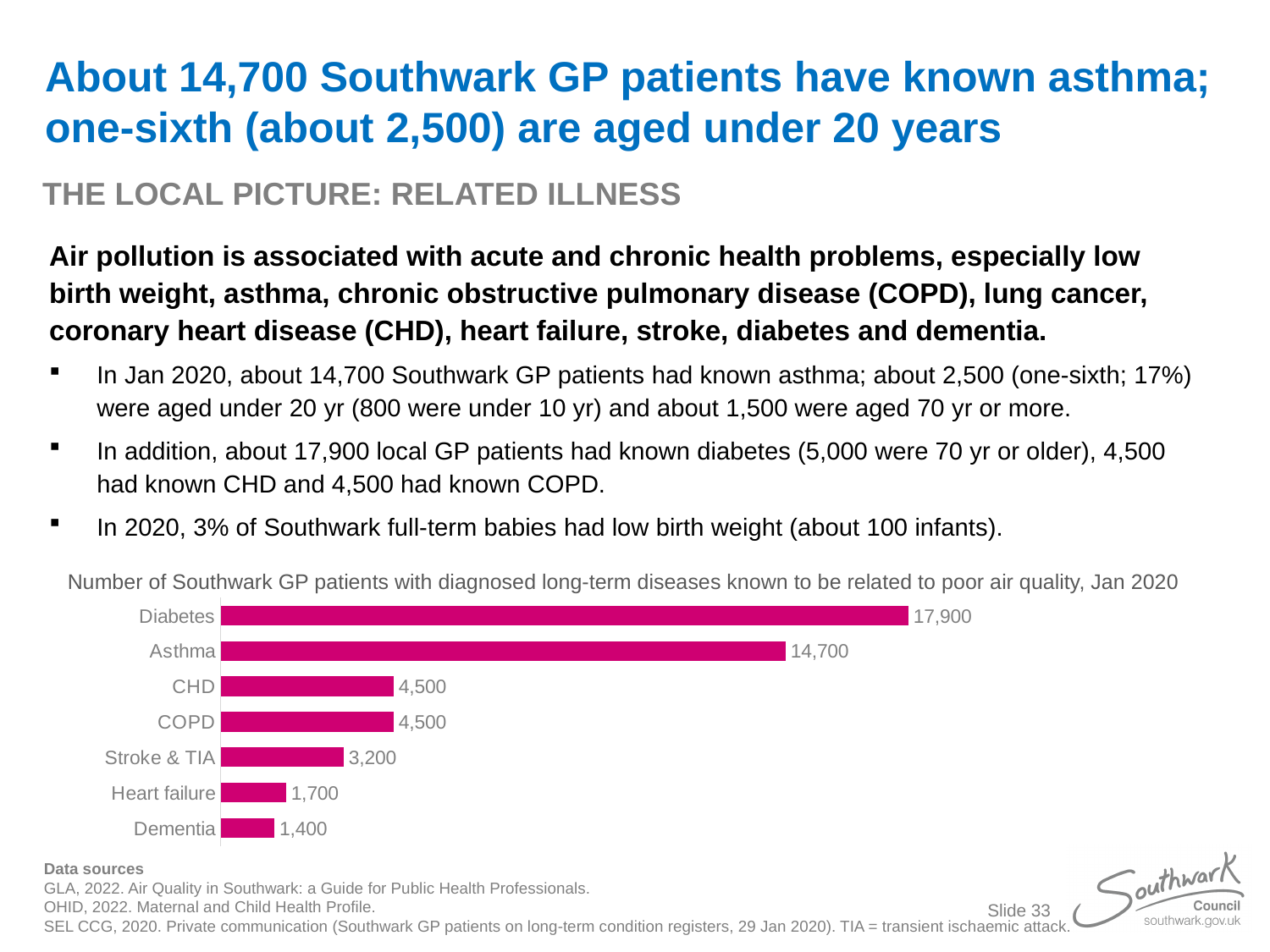
What value does the chart show for Heart failure? 1,700 What is the number of Southwark GP patients with diagnosed diabetes shown in the chart? 17,900 Which condition has the highest number of patients in the chart? Diabetes Which has more patients in the chart, Heart failure or Dementia? Heart failure What type of chart is shown on the slide? Bar chart What is the number of Southwark GP patients with diagnosed asthma shown in the chart? 14,700 What is the difference between the number of patients with Stroke & TIA and the number with Dementia? 1,800 What is the title of the chart on the slide? Number of Southwark GP patients with diagnosed long-term diseases known to be related to poor air quality, Jan 2020 How many conditions (categories) are shown in the chart? 7 What is the difference between the number of patients with diabetes and the number with asthma? 3,200 What value does the chart show for Stroke & TIA? 3,200 Which condition has the lowest number of patients in the chart? Dementia